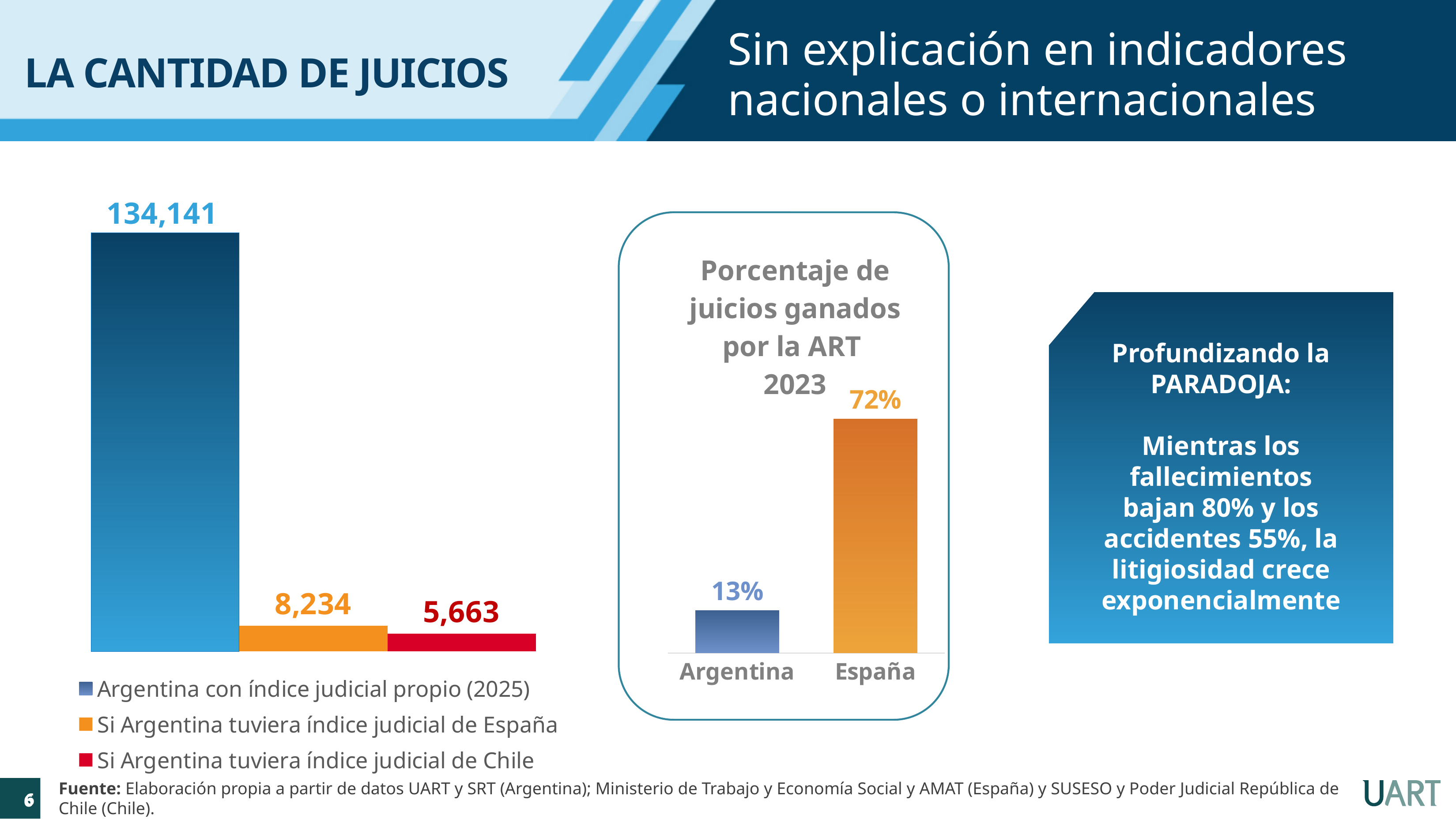
In the chart titled 'Porcentaje de juicios ganados por la ART 2023', what is the difference between the values for España and Argentina? 59% In the chart titled 'Porcentaje de juicios ganados por la ART 2023', what is the value for Argentina? 13% In the chart titled 'Porcentaje de juicios ganados por la ART 2023', what is the value for España? 72% In the left-hand bar chart, what is the value for 'Si Argentina tuviera índice judicial de España'? 8,234 What kind of chart is the chart titled 'Porcentaje de juicios ganados por la ART 2023'? Bar chart In the left-hand bar chart, what is the difference between the value for 'Si Argentina tuviera índice judicial de España' and the value for 'Si Argentina tuviera índice judicial de Chile'? 2,571 In the left-hand bar chart, how many series does the legend list? 3 In the left-hand bar chart, which series has the lowest value? Si Argentina tuviera índice judicial de Chile In the chart titled 'Porcentaje de juicios ganados por la ART 2023', which category has the higher value, Argentina or España? España In the left-hand bar chart, what colour is the bar for 'Si Argentina tuviera índice judicial de Chile'? Red In the left-hand bar chart, what is the value for 'Argentina con índice judicial propio (2025)'? 134,141 In the left-hand bar chart, what is the value for 'Si Argentina tuviera índice judicial de Chile'? 5,663